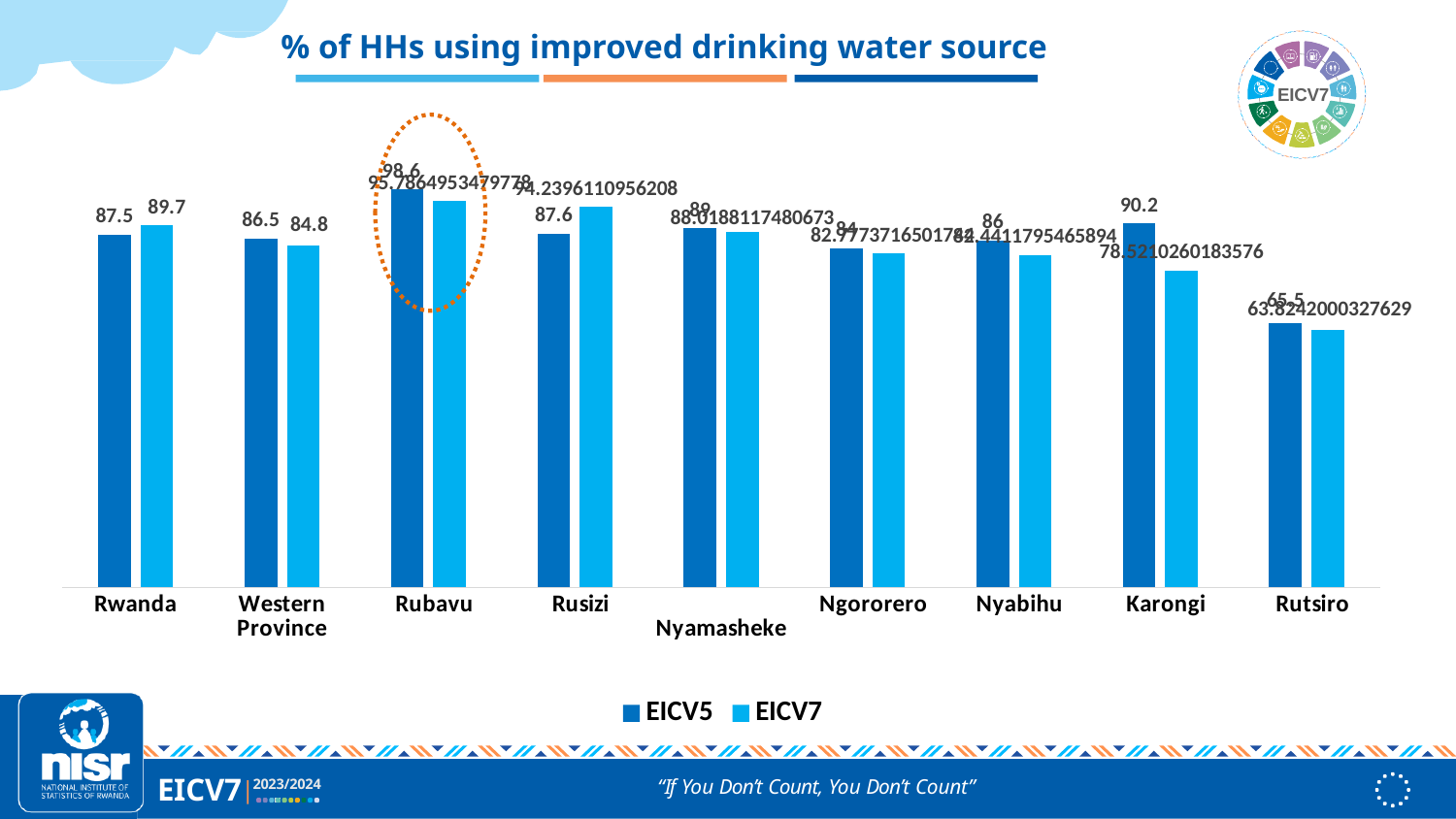
How many series does the legend list? 2 Which category has the highest EICV5 value? Rubavu What kind of chart is shown on the slide? bar chart What is the title of the chart? % of HHs using improved drinking water source How many categories are shown on the x axis? 9 What is the EICV5 value for Rutsiro? 65.5 What is the EICV7 value for Rwanda? 89.7 For Karongi, which is larger, the EICV5 value or the EICV7 value? EICV5 Which category has the lowest EICV7 value? Rutsiro What is the EICV5 value for Western Province? 86.5 What is the EICV5 value for Karongi? 90.2 What is the difference between the EICV7 and EICV5 values for Rwanda? 2.2